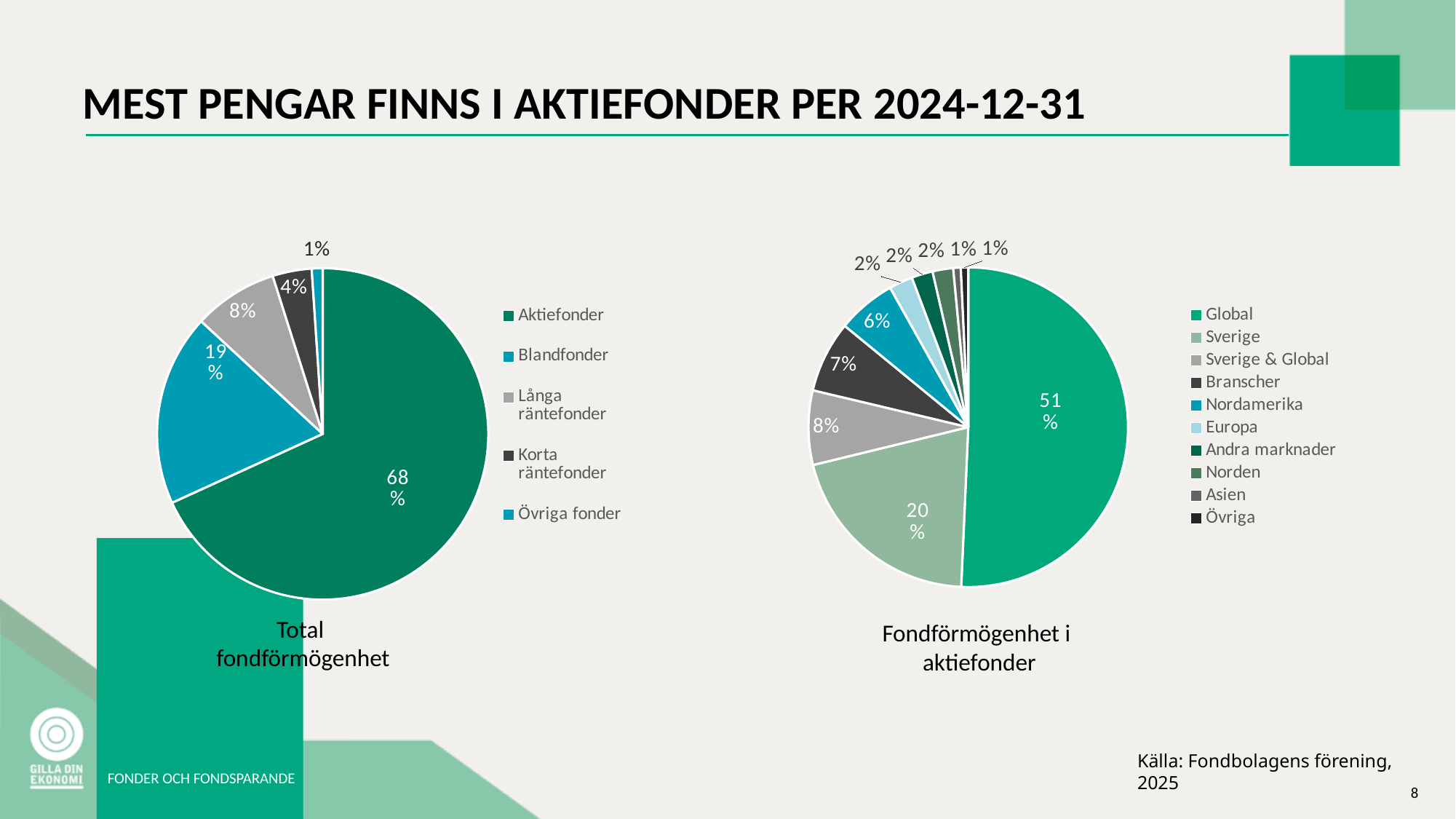
In the 'Total fondförmögenhet' chart, which category has the smallest share? Övriga fonder In the 'Total fondförmögenhet' chart, what share does Aktiefonder have? 68% In the 'Fondförmögenhet i aktiefonder' chart, what share does Sverige have? 20% In the 'Total fondförmögenhet' chart, what is the difference in percentage points between Aktiefonder and Blandfonder? 49 In the 'Total fondförmögenhet' chart, how many categories does the legend list? 5 In the 'Fondförmögenhet i aktiefonder' chart, what is the difference in percentage points between Sverige and Sverige & Global? 12 In the 'Fondförmögenhet i aktiefonder' chart, how many categories does the legend list? 10 In the 'Fondförmögenhet i aktiefonder' chart, which is larger, Branscher or Nordamerika? Branscher In the 'Total fondförmögenhet' chart, what share does Blandfonder have? 19% What kind of chart is 'Fondförmögenhet i aktiefonder'? Pie chart In the 'Fondförmögenhet i aktiefonder' chart, which category has the largest share? Global In the 'Fondförmögenhet i aktiefonder' chart, what share does Global have? 51%